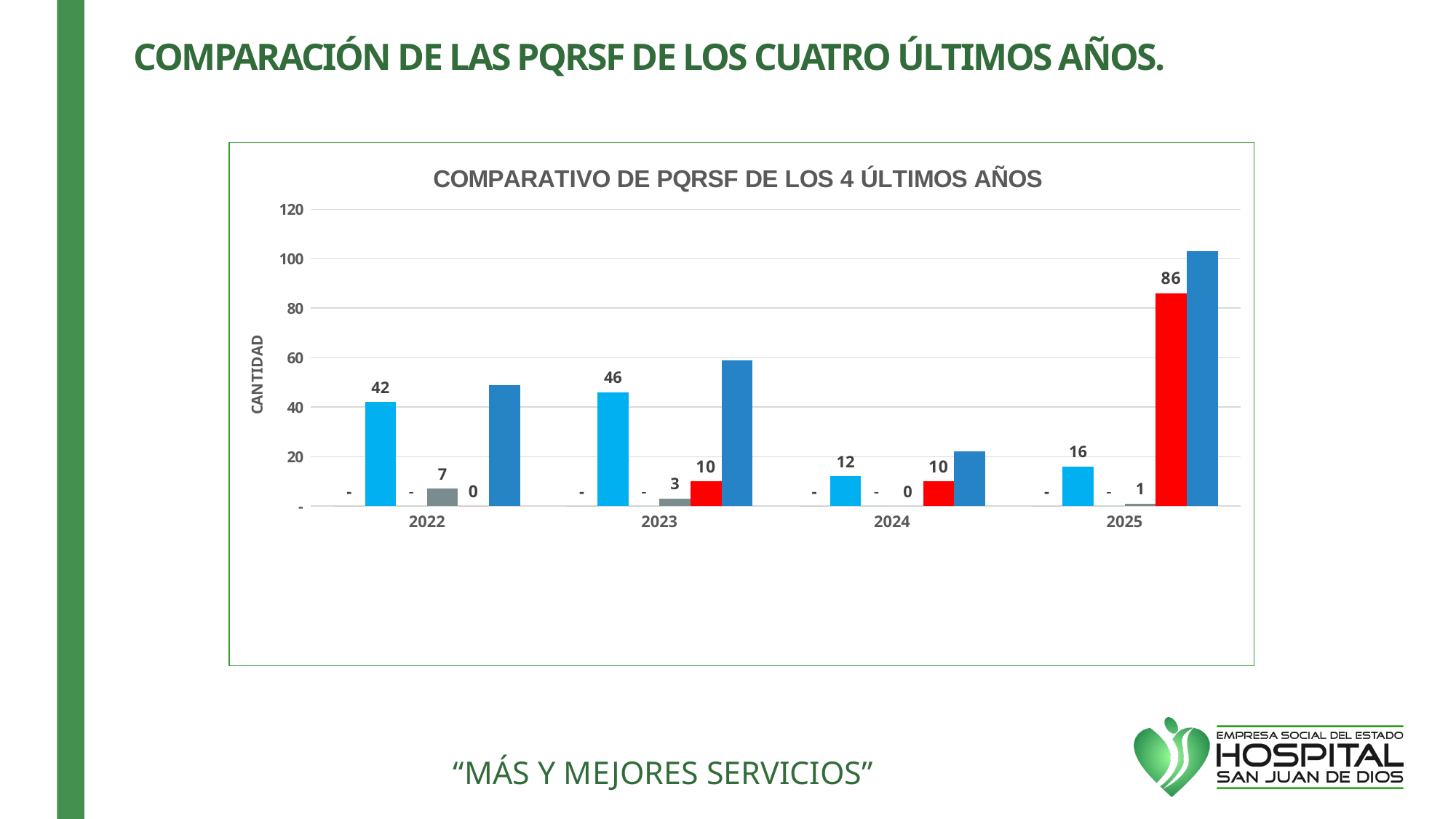
How many years are shown on the x axis of the chart? 4 What is the value of the red bar for 2025? 86 What is the value of the light blue bar for 2022? 42 Is the value of the dark blue bar for 2025 greater or less than 100? greater For 2025, which is larger: the red bar or the light blue bar? the red bar What is the label on the vertical axis of the chart? CANTIDAD What is the value of the light blue bar for 2023? 46 What kind of chart is shown on the slide? bar chart In which year is the light blue bar highest? 2023 What is the value of the grey bar for 2022? 7 In which year is the light blue bar lowest? 2024 What is the difference between the red bar for 2025 and the red bar for 2023? 76